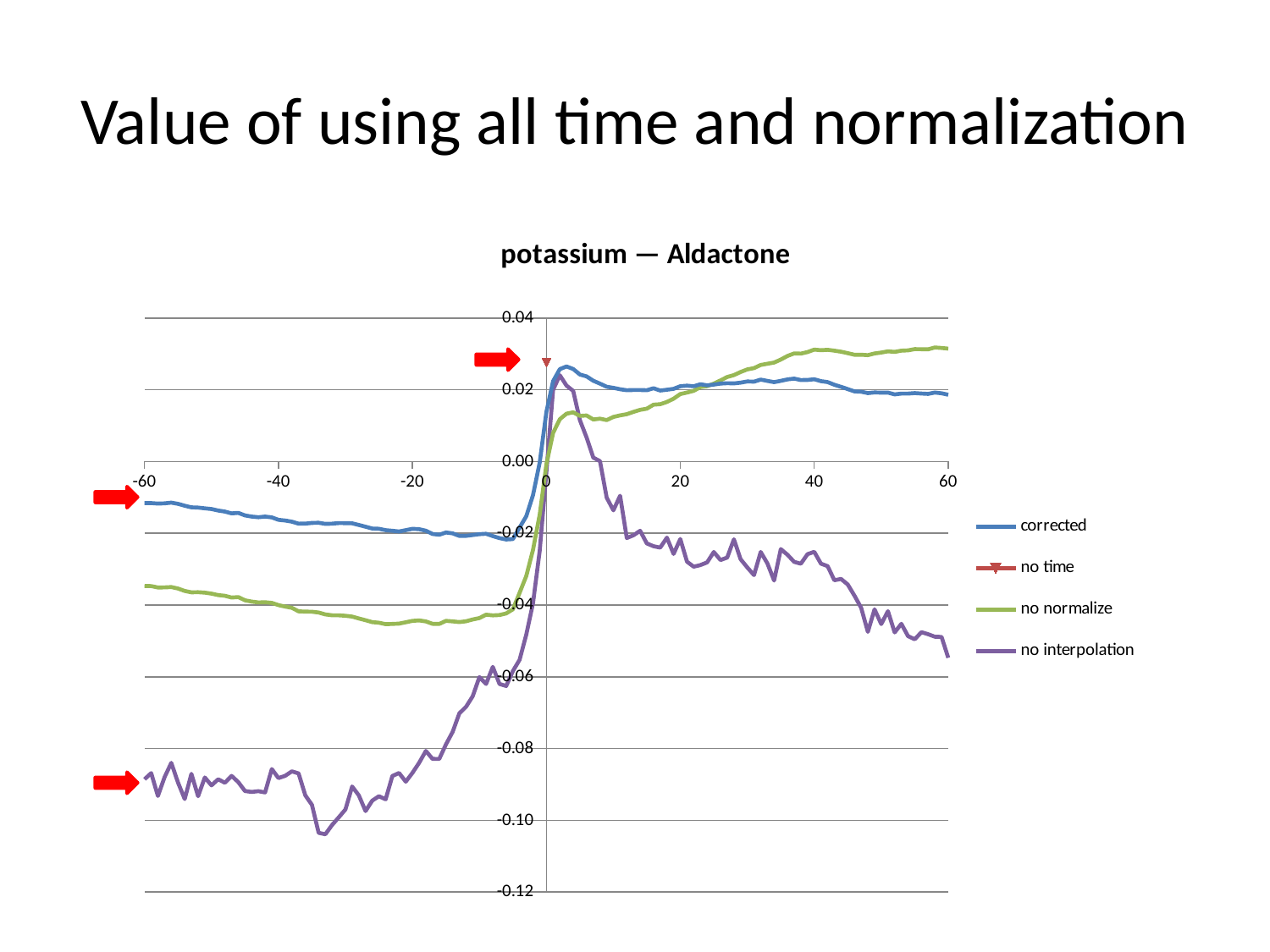
What is the title of the chart? potassium — Aldactone What kind of chart is shown on the slide? line chart At x = 60, which series has the higher value: 'corrected' or 'no normalize'? no normalize Which series in the legend is drawn with a triangle marker? no time Is the value of the 'no interpolation' series at x = -60 greater or less than -0.08? less At x = -60, which series has the higher value: 'corrected' or 'no normalize'? corrected Does the 'no interpolation' series generally rise or fall between x = 20 and x = 60? fall Is the value of the 'no normalize' series at x = 60 greater or less than 0.02? greater Which series has the lowest value at x = -60? no interpolation Is the value of the 'no interpolation' series at x = 60 greater or less than -0.04? less How many series does the legend list? 4